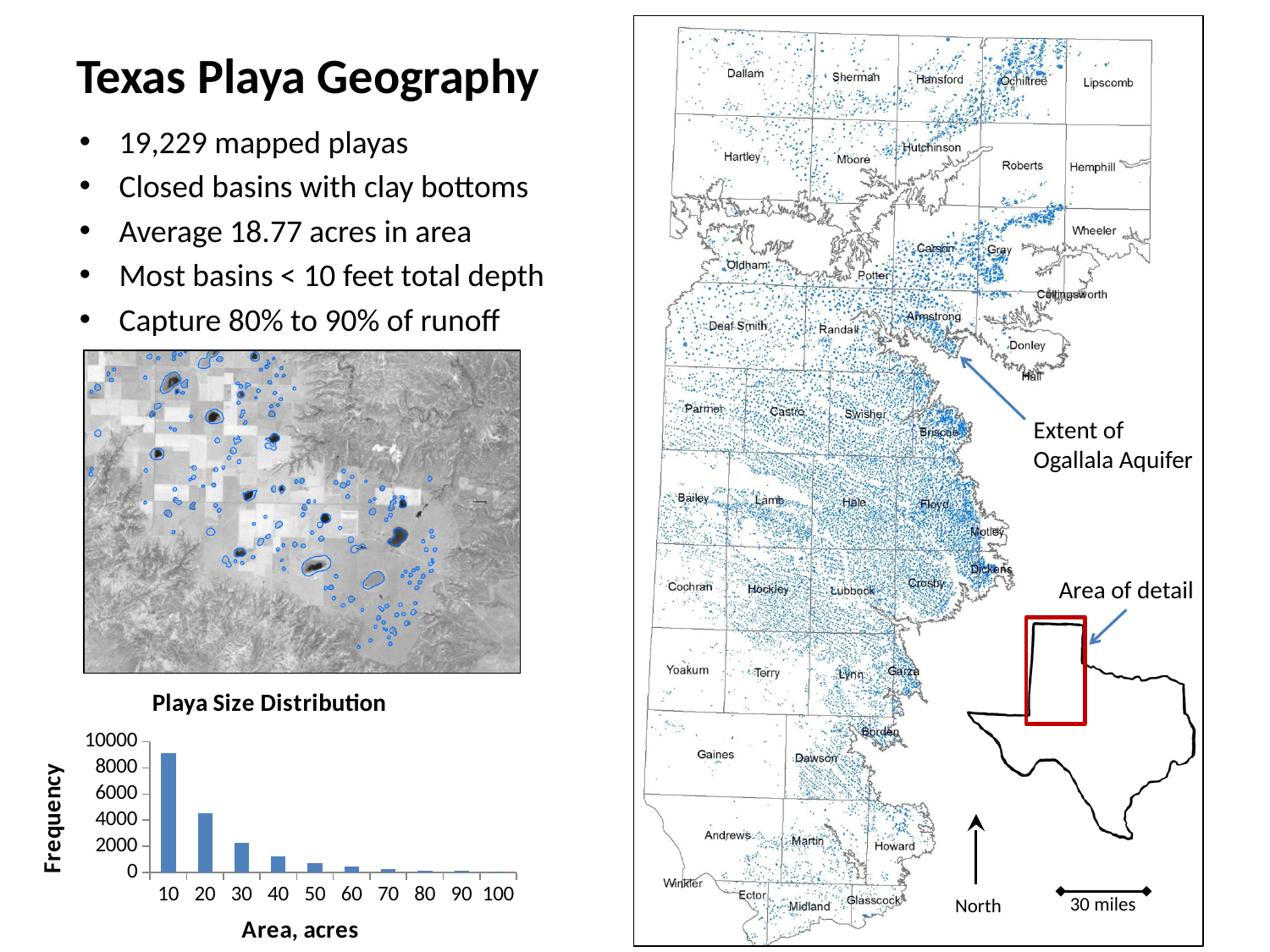
In the Playa Size Distribution chart, is the frequency for 40 acres greater or less than 2000? less What is the x-axis label of the Playa Size Distribution chart? Area, acres How many area categories are shown on the x axis of the Playa Size Distribution chart? 10 In the Playa Size Distribution chart, is the frequency for 30 acres greater or less than 4000? less What kind of chart is the Playa Size Distribution chart? bar chart In the Playa Size Distribution chart, is the frequency for 10 acres greater or less than 8000? greater In the Playa Size Distribution chart, which has the higher frequency, 20 acres or 30 acres? 20 acres What is the title of the bar chart on the slide? Playa Size Distribution Which area category has the highest frequency in the Playa Size Distribution chart? 10 Do the frequencies rise or fall as area increases along the x axis of the Playa Size Distribution chart? fall In the Playa Size Distribution chart, which has the higher frequency, 10 acres or 20 acres? 10 acres